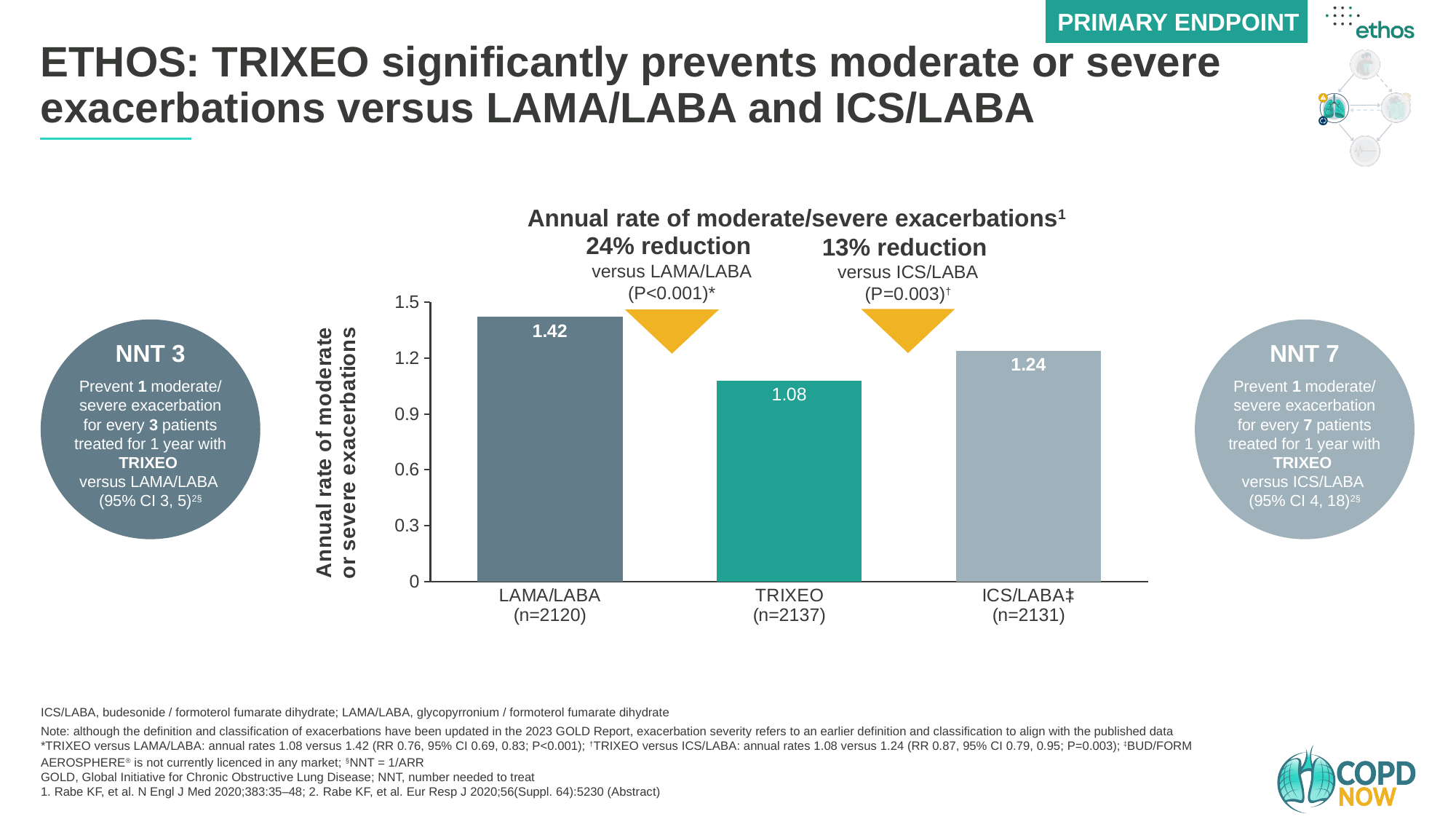
What is the annual rate of moderate/severe exacerbations for ICS/LABA? 1.24 What is the title of the chart? Annual rate of moderate/severe exacerbations Which treatment group has the highest annual rate of moderate/severe exacerbations? LAMA/LABA What is the difference in annual exacerbation rate between ICS/LABA and TRIXEO? 0.16 Which treatment group has the lowest annual rate of moderate/severe exacerbations? TRIXEO What is the annual rate of moderate/severe exacerbations for TRIXEO? 1.08 How many treatment groups are shown in the chart? 3 What is the annual rate of moderate/severe exacerbations for LAMA/LABA? 1.42 Which has a higher annual exacerbation rate, LAMA/LABA or ICS/LABA? LAMA/LABA Is the annual exacerbation rate for TRIXEO greater or less than 1.2? less What is the difference in annual exacerbation rate between LAMA/LABA and TRIXEO? 0.34 What kind of chart is used to show the annual rate of moderate/severe exacerbations? Bar chart